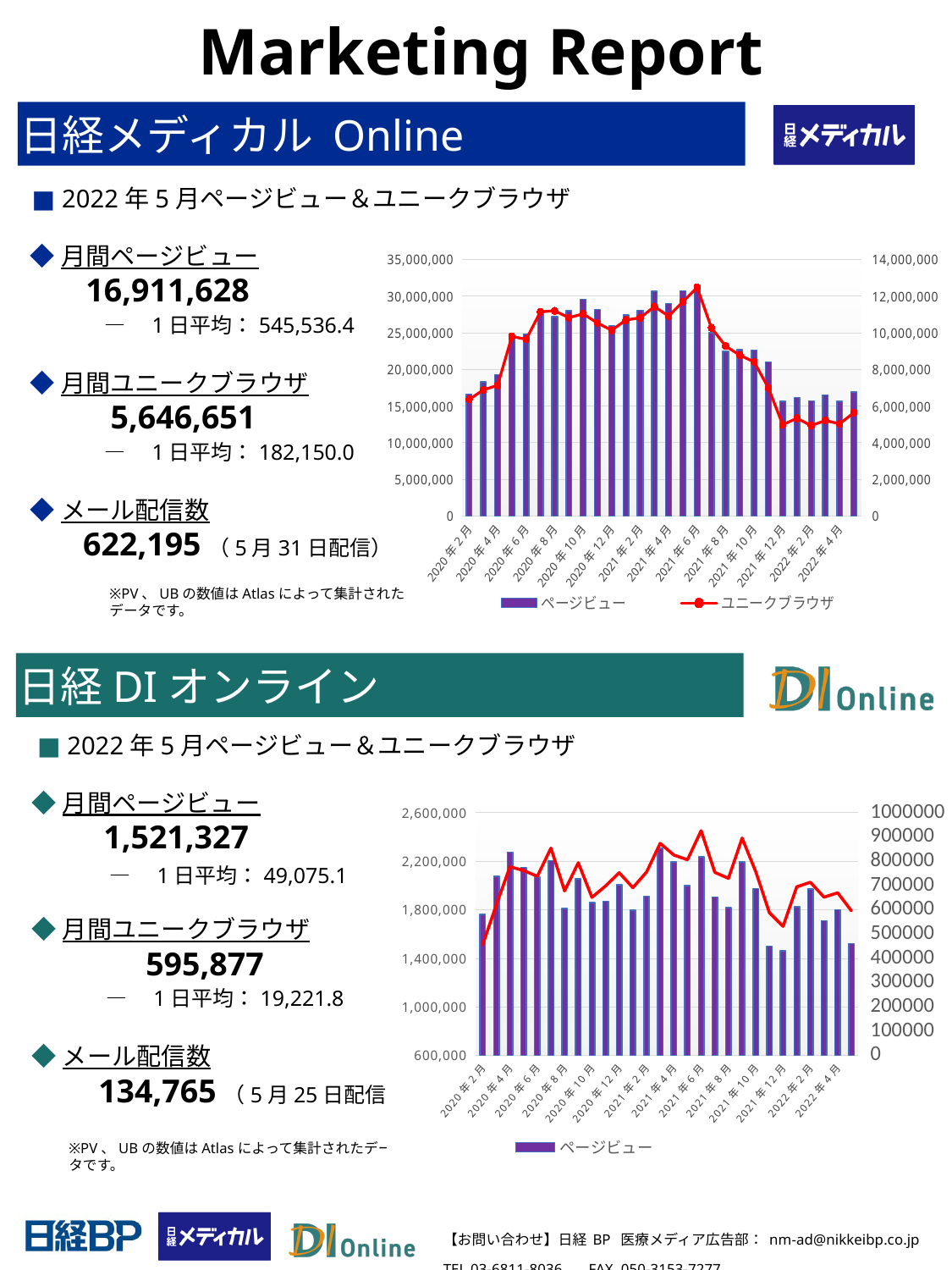
In the bottom chart (日経DIオンライン), is the ページビュー value for 2020年4月 greater or less than 2,000,000? greater In the top chart (日経メディカル Online), which has the larger ページビュー value, 2021年4月 or 2022年4月? 2021年4月 In the top chart (日経メディカル Online), which series is drawn as a red line? ユニークブラウザ How many series does the legend of the top chart (日経メディカル Online) list? 2 In the bottom chart (日経DIオンライン), which has the larger ページビュー value, 2020年4月 or 2022年4月? 2020年4月 In the top chart (日経メディカル Online), do the ページビュー values rise or fall from 2021年6月 to 2022年4月? fall How many series does the legend of the bottom chart (日経DIオンライン) list? 1 In the top chart (日経メディカル Online), is the ページビュー value for 2021年4月 greater or less than 25,000,000? greater In the bottom chart (日経DIオンライン), is the ページビュー value for 2021年12月 greater or less than 1,800,000? less What kind of chart is the 日経メディカル Online chart (top chart)? Combined bar and line chart What is the highest tick on the left axis of the top chart (日経メディカル Online)? 35,000,000